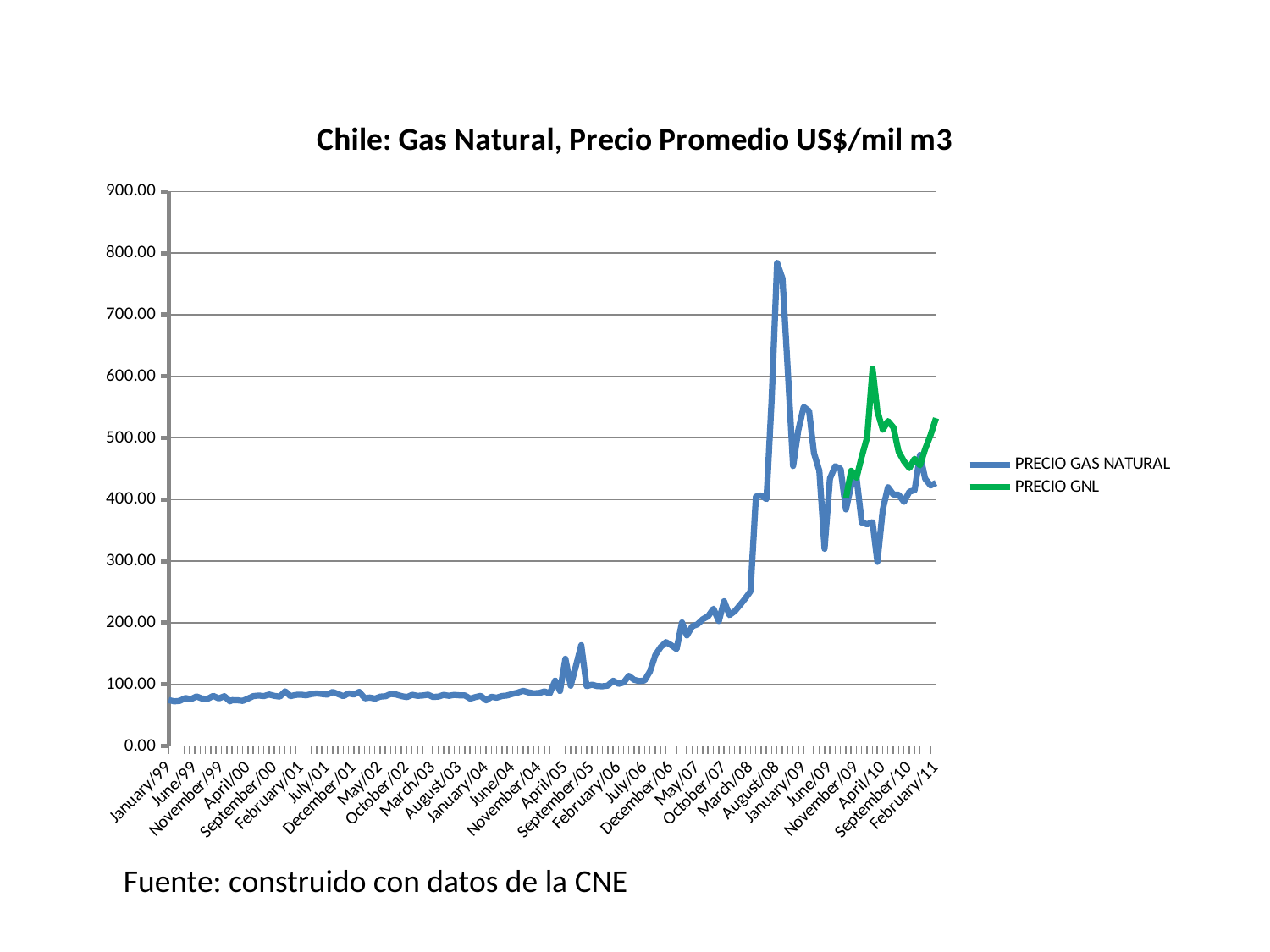
At February/11, which series has the higher value, PRECIO GAS NATURAL or PRECIO GNL? PRECIO GNL Which colour is used for the PRECIO GNL series? Green Is the value for PRECIO GAS NATURAL in February/11 greater or less than 500.00? less How many series does the legend list? 2 Does the PRECIO GAS NATURAL series rise or fall overall from January/99 to August/08? Rise Is the highest value of PRECIO GNL greater or less than 500.00? greater Is the peak value of PRECIO GAS NATURAL around August/08 greater or less than 700.00? greater What kind of chart is shown on the slide? Line chart What is the highest value shown on the vertical axis? 900.00 Which series reaches the highest value on the chart? PRECIO GAS NATURAL What is the title of the chart? Chile: Gas Natural, Precio Promedio US$/mil m3